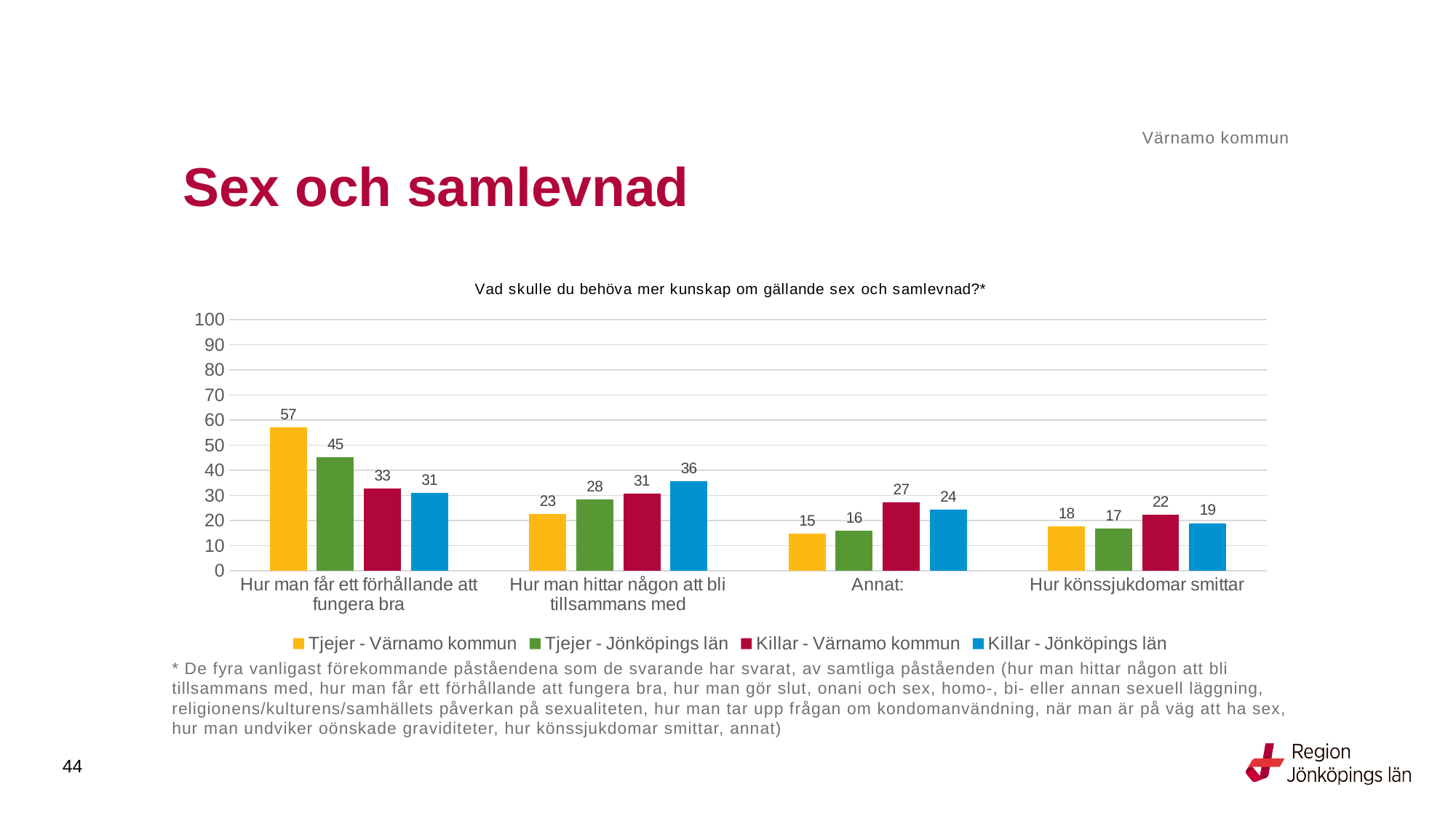
For 'Hur könssjukdomar smittar', which is larger: Killar - Värnamo kommun or Killar - Jönköpings län? Killar - Värnamo kommun Which category has the lowest value for Tjejer - Jönköpings län? Annat: How many series does the legend list? 4 What is the title of the chart? Vad skulle du behöva mer kunskap om gällande sex och samlevnad?* How many categories are shown on the x axis? 4 What is the difference between Tjejer - Värnamo kommun and Tjejer - Jönköpings län for 'Hur man får ett förhållande att fungera bra'? 12 What is the value for Tjejer - Värnamo kommun for 'Hur man får ett förhållande att fungera bra'? 57 What is the value for Killar - Jönköpings län for 'Hur man hittar någon att bli tillsammans med'? 36 What kind of chart is shown on the slide? bar chart Which category has the highest value for Tjejer - Värnamo kommun? Hur man får ett förhållande att fungera bra Is the value for Tjejer - Värnamo kommun for 'Hur man hittar någon att bli tillsammans med' greater or less than 30? less What is the value for Killar - Värnamo kommun for 'Annat:'? 27